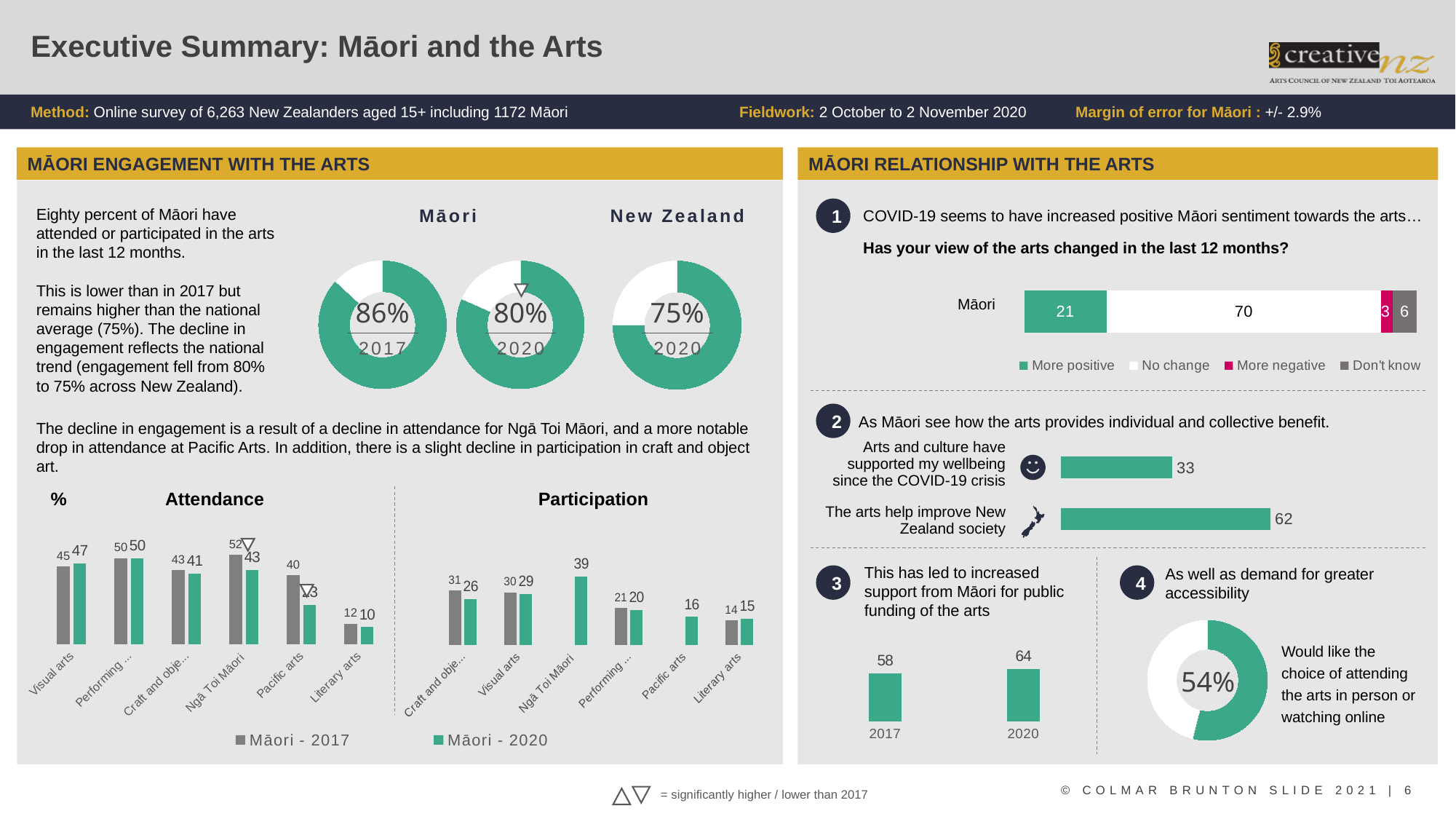
In the Attendance chart, which category has the lowest Māori - 2020 value? Literary arts In the 'Has your view of the arts changed in the last 12 months?' stacked bar, what value is shown for 'No change'? 70 What is the total of the 'Has your view of the arts changed in the last 12 months?' stacked bar for Māori? 100 In the Participation chart, which category has the highest Māori - 2020 value? Ngā Toi Māori How many series does the legend of the 'Has your view of the arts changed in the last 12 months?' chart list? 4 In the Attendance chart, what is the difference between the Māori - 2017 and Māori - 2020 values for Ngā Toi Māori? 9 In the Attendance chart, what is the Māori - 2020 value for Visual arts? 47 In the 'Has your view of the arts changed in the last 12 months?' stacked bar, what value is shown for 'More positive'? 21 In the Participation chart, what is the Māori - 2020 value for Ngā Toi Māori? 39 In the Attendance chart, what is the Māori - 2017 value for Ngā Toi Māori? 52 In the chart under point 2, what value is shown for 'The arts help improve New Zealand society'? 62 In the chart under point 3 about support for public funding of the arts, what is the value for 2020? 64